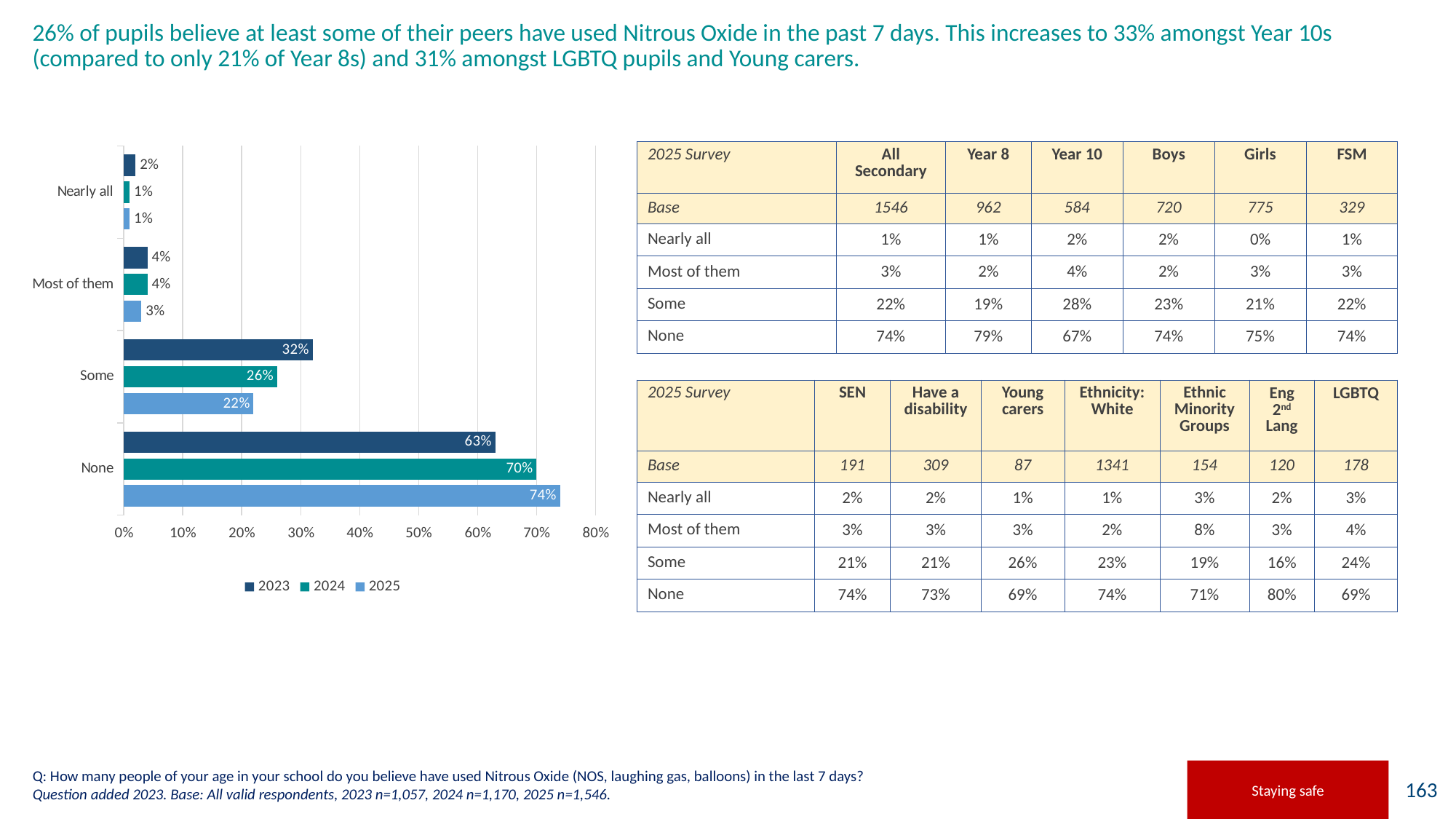
In the bar chart, how does the value for 'Some' change from 2023 to 2025? It falls Which category has the highest value for the 2025 series in the bar chart? None What are the series listed in the bar chart legend? 2023, 2024, 2025 In the bar chart, is the 2024 value for 'Some' larger or smaller than the 2025 value for 'Some'? larger What is the 2023 value for 'Some' in the bar chart? 32% How many series does the bar chart legend list? 3 How many categories are shown on the bar chart? 4 Which category has the lowest value for the 2023 series in the bar chart? Nearly all What is the 2024 value for 'Most of them' in the bar chart? 4% What kind of chart is shown on the slide? bar chart What is the difference between the 2025 and 2023 values for 'None' in the bar chart? 11 percentage points What is the 2025 value for 'None' in the bar chart? 74%